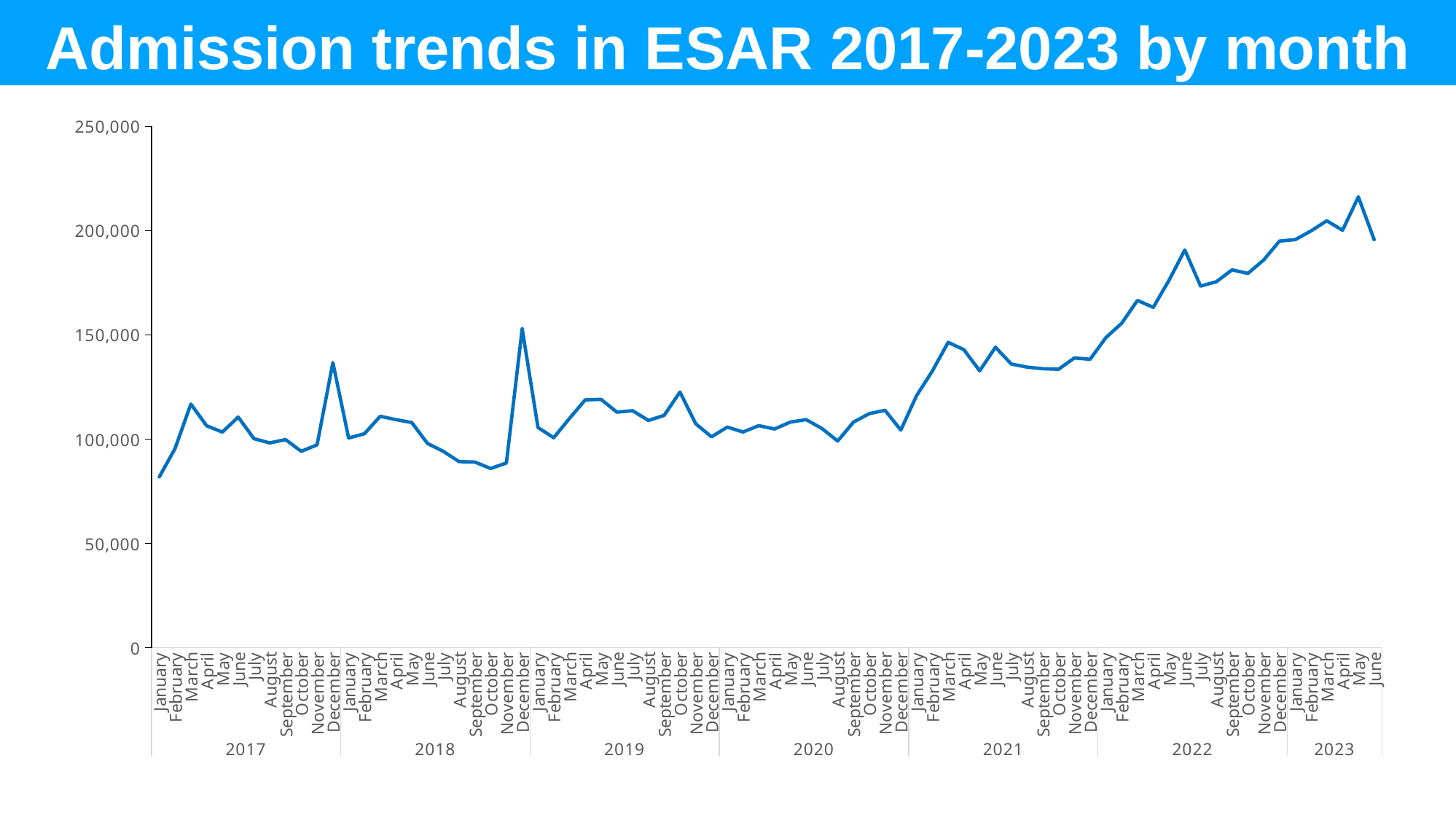
What kind of chart is shown on the slide? Line chart How many years are labelled along the x axis of the chart? 7 What is the title of the chart? Admission trends in ESAR 2017-2023 by month In which month and year does the line reach its highest value? May 2023 Which is larger, the value for December 2018 or the value for December 2017? December 2018 Is the value for January 2017 greater or less than 100,000? less Is the value for December 2017 greater or less than 150,000? less Is the value for May 2023 greater or less than 200,000? greater Overall, do admissions rise or fall from 2020 to 2023 along the x axis? Rise How many monthly data points are plotted on the chart (January 2017 to June 2023)? 78